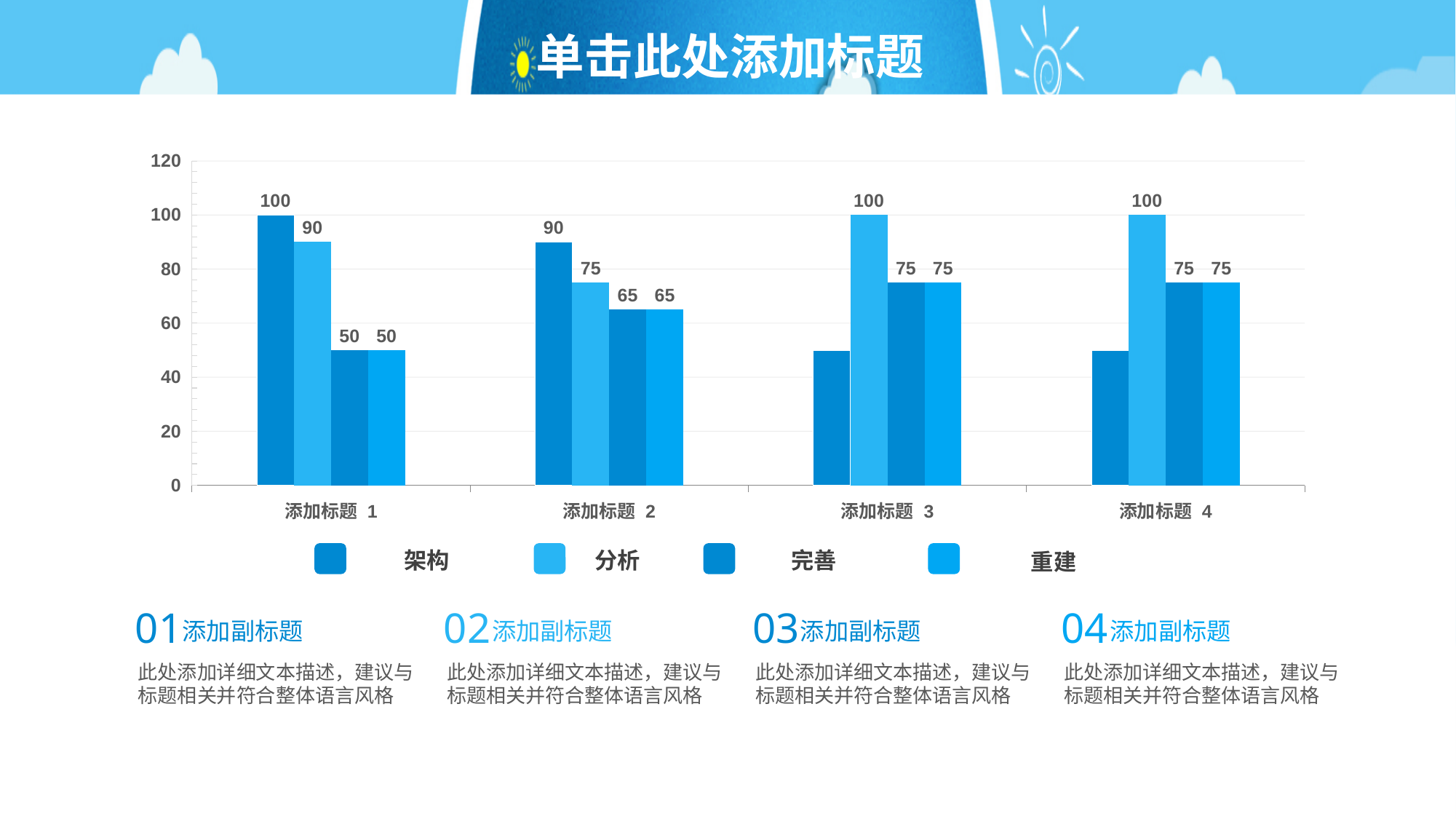
Is the value of 架构 for 添加标题 3 greater or less than 60? less What is the value of 完善 for 添加标题 3? 75 Which series has the lowest value for 添加标题 2? 完善 and 重建 (both 65) What is the value of 架构 for 添加标题 1? 100 Which is larger for 添加标题 2: 架构 or 完善? 架构 How many categories are shown on the x axis? 4 How many series does the legend list? 4 What kind of chart is shown on the slide? bar chart Which series has the highest value for 添加标题 4? 分析 What is the difference between 架构 and 分析 for 添加标题 1? 10 What is the value of 分析 for 添加标题 2? 75 What is the value of 重建 for 添加标题 1? 50